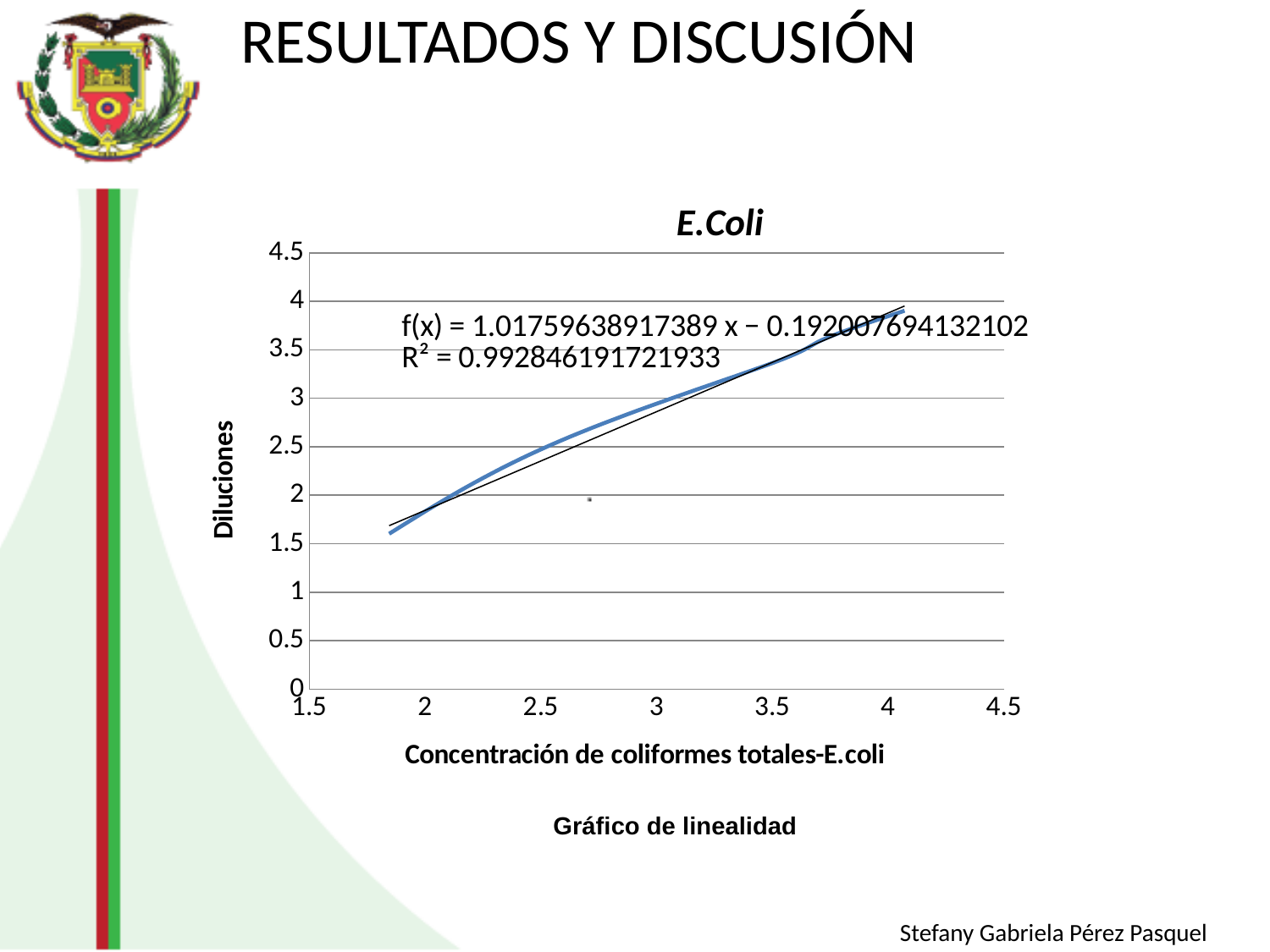
What is the slope of the fitted line f(x) shown on the chart? 1.01759638917389 What is the label of the x axis of the chart? Concentración de coliformes totales-E.coli Do the Diluciones values rise or fall as the concentration increases along the x axis? rise What is the intercept of the fitted line f(x) shown on the chart? −0.192007694132102 What is the title of the chart? E.Coli Is the Diluciones value at a concentration of 3.5 greater or less than 3? greater Is the Diluciones value at a concentration of 4 greater or less than 3.5? greater Is the Diluciones value at a concentration of 4 greater or less than 4? less What R² value is printed on the chart? R² = 0.992846191721933 What is the highest value shown on the y axis of the chart? 4.5 What kind of chart is shown on the slide? line chart